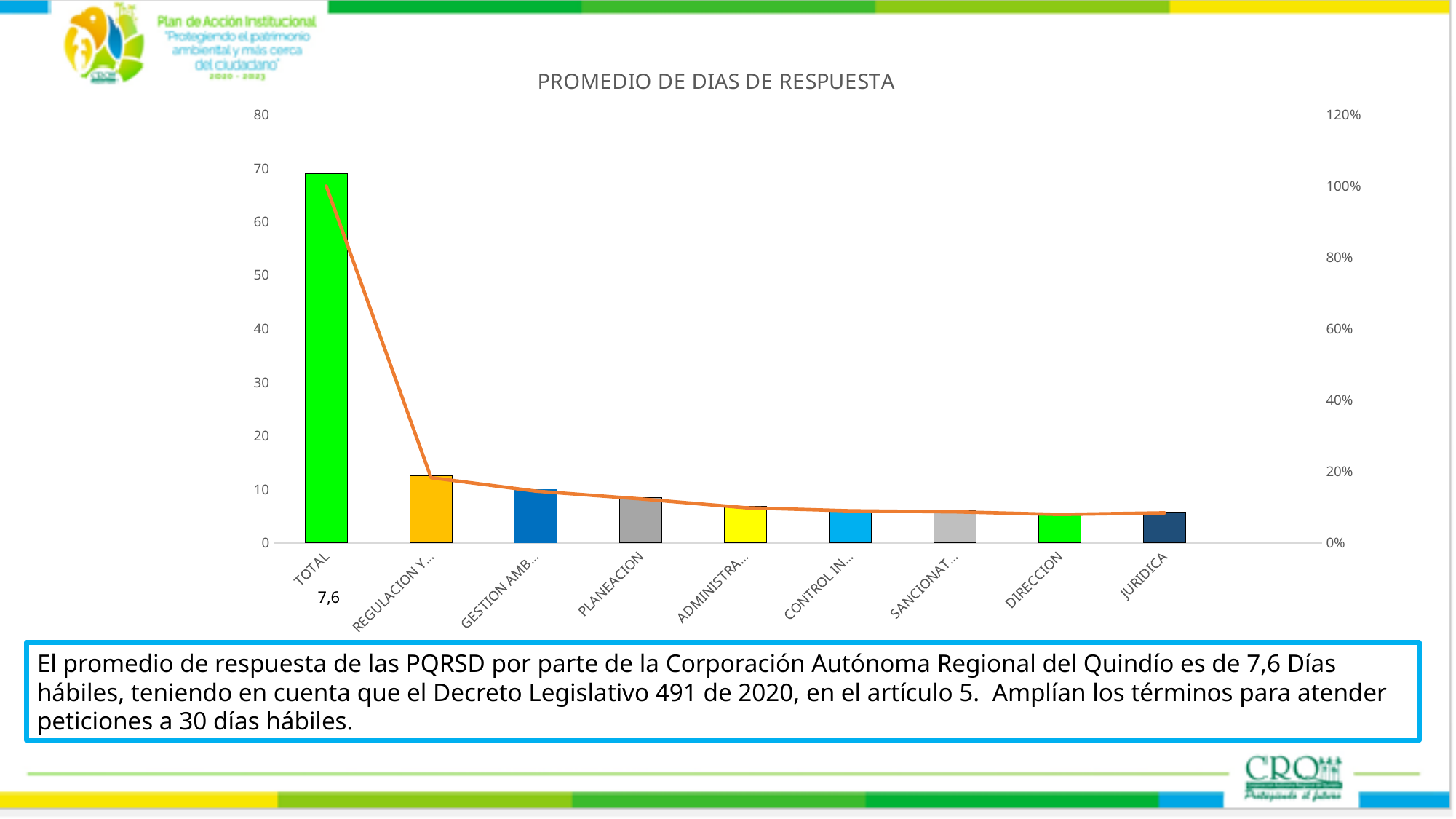
What kind of chart is shown on the slide? Bar chart with a line overlay What is the title of the chart? PROMEDIO DE DIAS DE RESPUESTA Do the bar values generally rise or fall from left to right along the x axis? fall Is the value for PLANEACION greater or less than 10? less Which category has the highest bar in the chart? TOTAL What is the highest tick value shown on the left vertical axis? 80 Is the value for GESTION AMB... greater or less than 20? less Which has a larger value, REGULACION Y... or PLANEACION? REGULACION Y... Which has a larger value, TOTAL or REGULACION Y...? TOTAL Is the value for REGULACION Y... greater or less than 20? less How many categories are shown on the x axis of the chart? 9